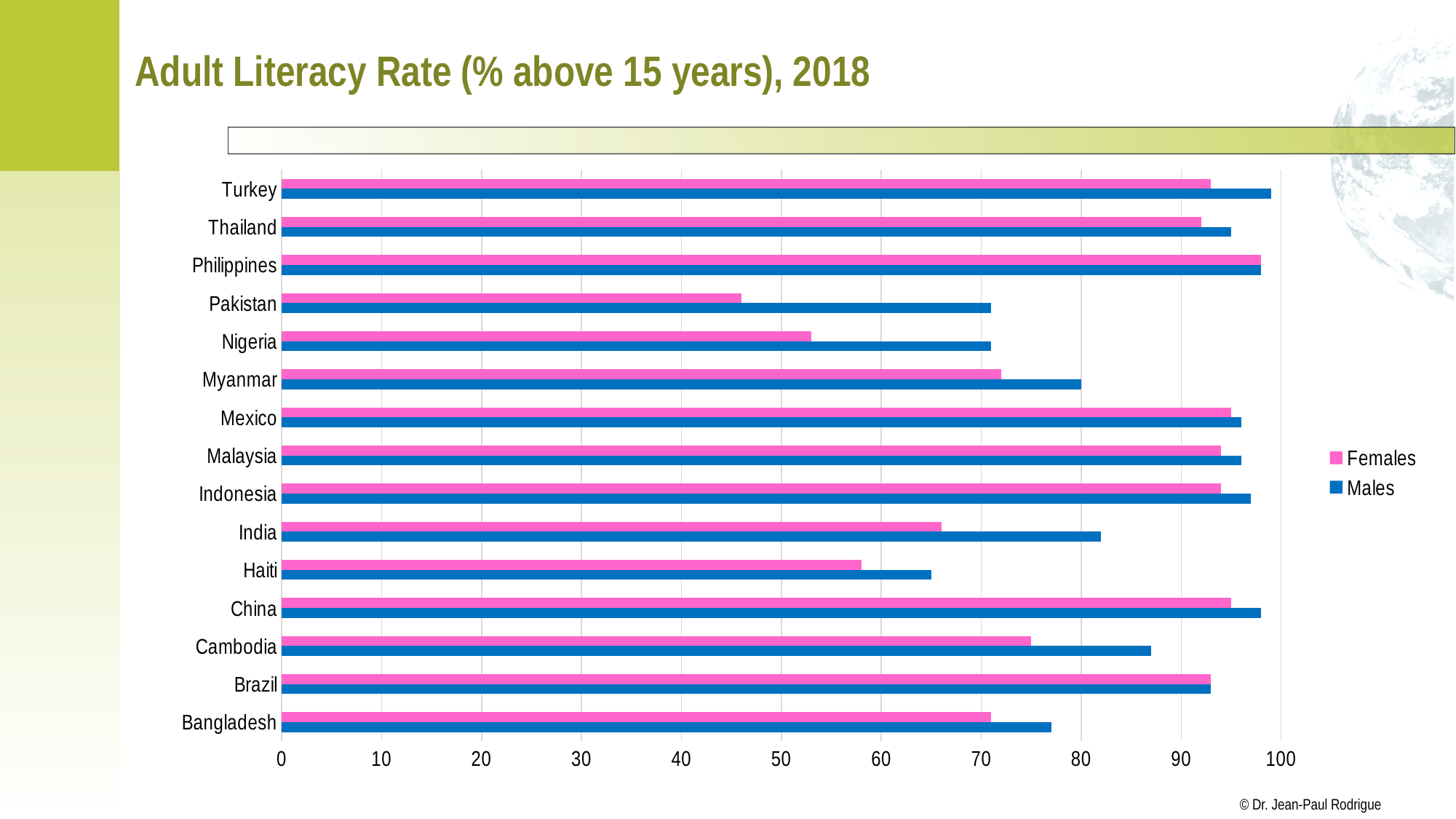
Is the male literacy rate for India greater or less than 80? greater How many countries are listed on the chart? 15 Which colour represents Females in the chart? pink How many series does the legend list? 2 What kind of chart is shown on the slide? bar chart Is the female literacy rate for Pakistan greater or less than 50? less Is the male literacy rate for Haiti greater or less than 70? less Which country has the lowest male adult literacy rate? Haiti Which is larger: the male literacy rate for Myanmar or for Pakistan? Myanmar Which is larger: the female literacy rate for Bangladesh or for India? Bangladesh Which country has the lowest female adult literacy rate? Pakistan